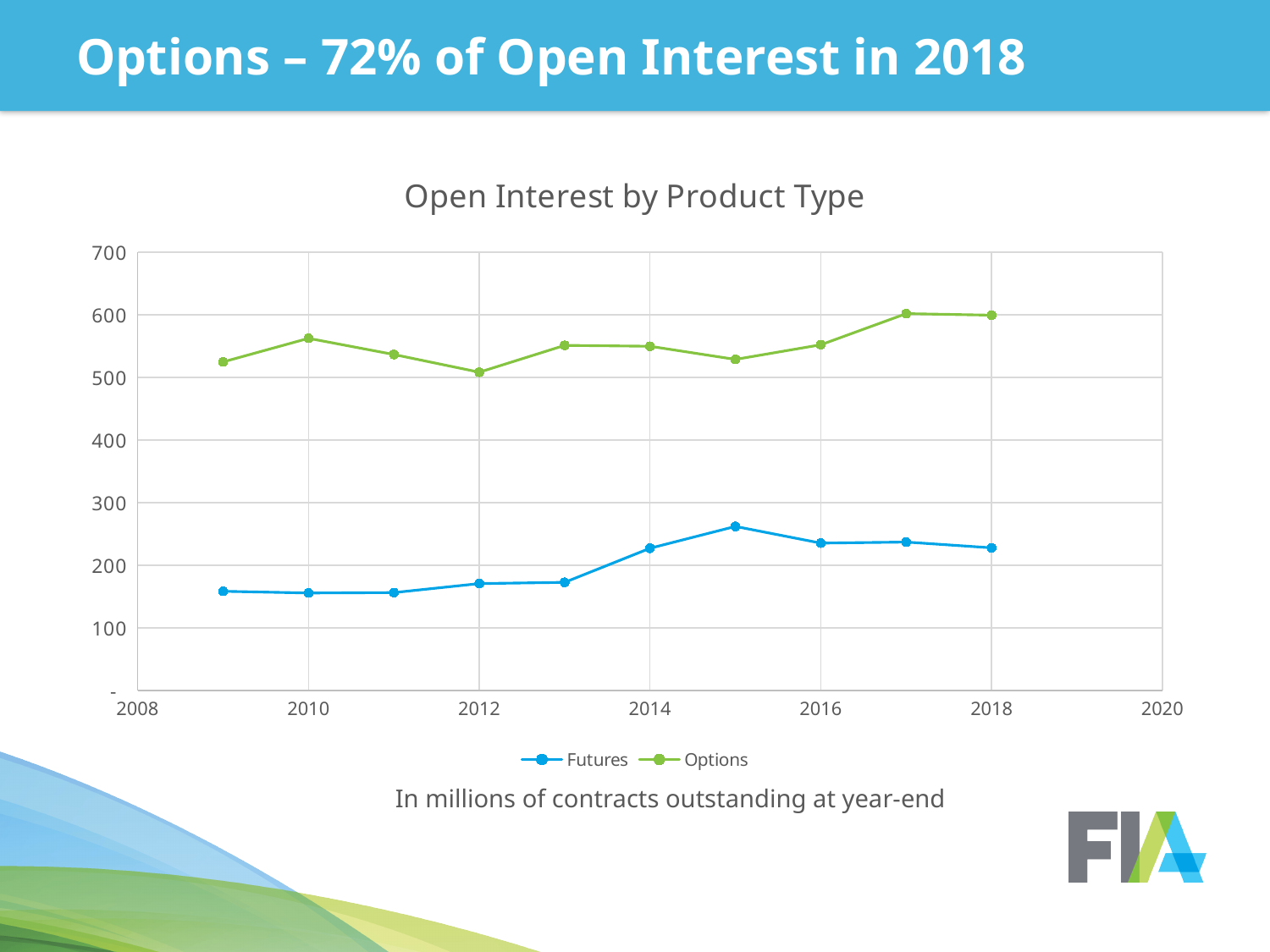
Is the value for Options in 2009 greater or less than 500? greater What is the title of the chart? Open Interest by Product Type What are the two series shown in the legend? Futures and Options Is the value for Futures in 2014 greater or less than 200? greater What type of chart is shown on the slide? line chart Which series has the higher value in 2018, Futures or Options? Options Is the value for Futures in 2009 greater or less than 200? less How many series does the legend list? 2 Does the Futures series rise or fall between 2013 and 2015? rise How many data points are plotted for the Options series? 10 In which year does the Futures series reach its highest value? 2015